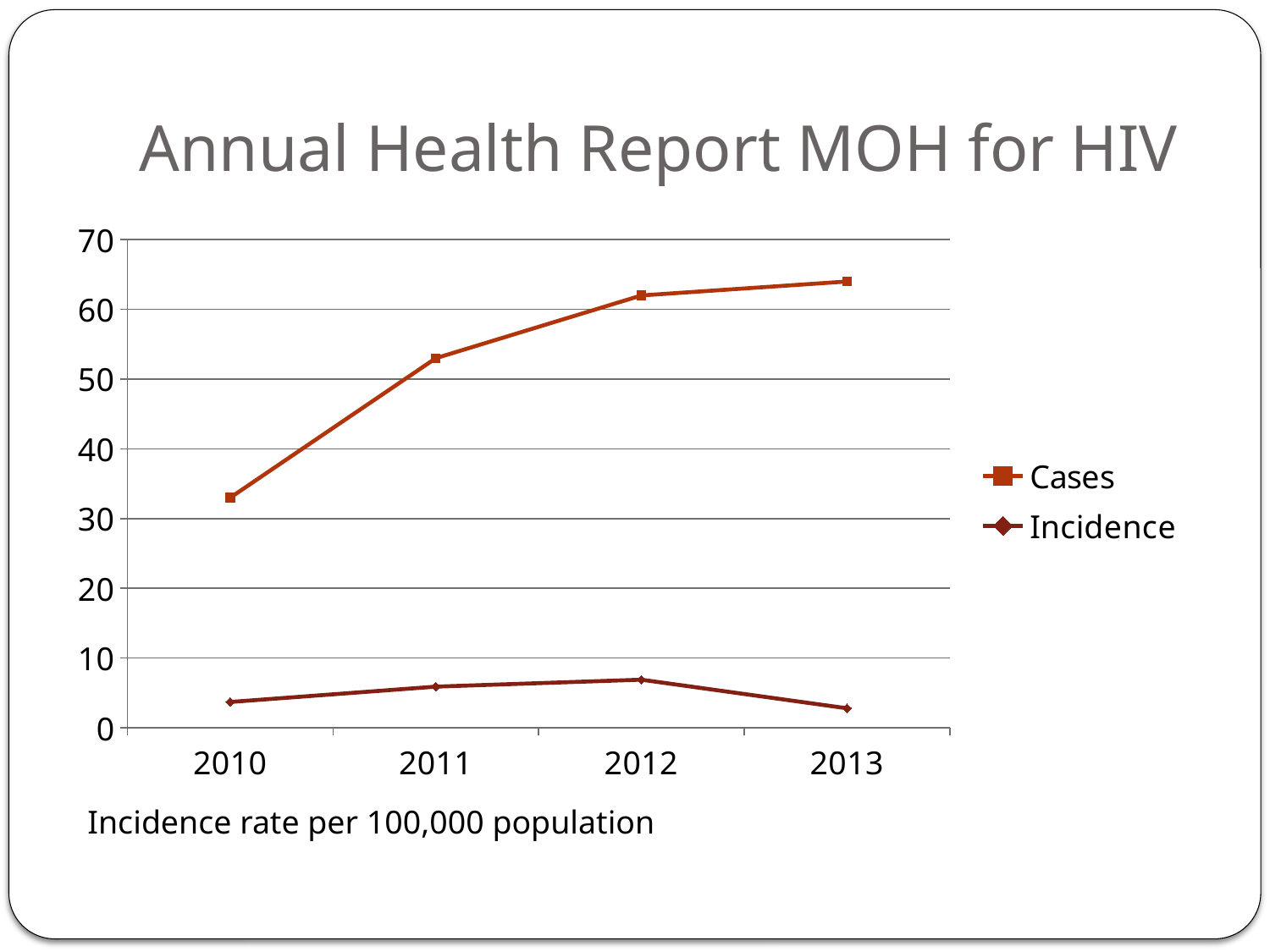
Which is larger, the Cases value in 2011 or the Cases value in 2010? 2011 Is the value for Incidence in 2012 greater or less than 10? less Is the value for Cases in 2011 greater or less than 50? greater How many series does the legend list? 2 Which year has the lowest value for Cases? 2010 How many years are plotted along the x axis? 4 What note is printed below the x axis of the chart? Incidence rate per 100,000 population What is the title of the chart? Annual Health Report MOH for HIV Is the value for Cases in 2010 greater or less than 30? greater Do the Cases values rise or fall from 2010 to 2013? rise What type of chart is shown on the slide? line chart